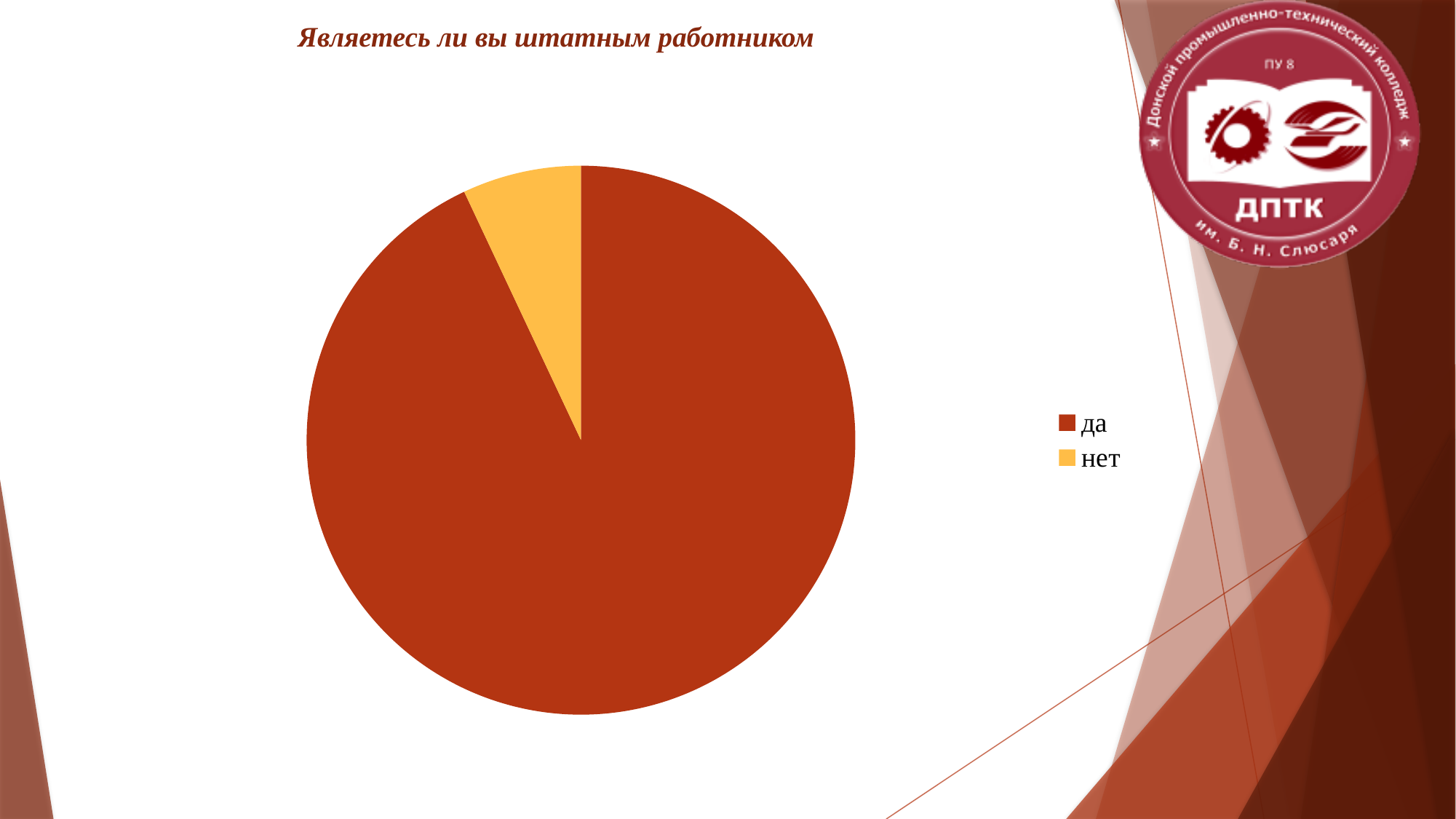
Which category has the smallest slice of the pie? нет How many slices does the pie chart have? 2 Which category has the largest slice of the pie? да What is the title of the chart? Являетесь ли вы штатным работником What kind of chart is shown on the slide? pie chart What colour is the slice for "нет"? yellow How many entries does the legend list? 2 Which slice is larger, "да" or "нет"? да